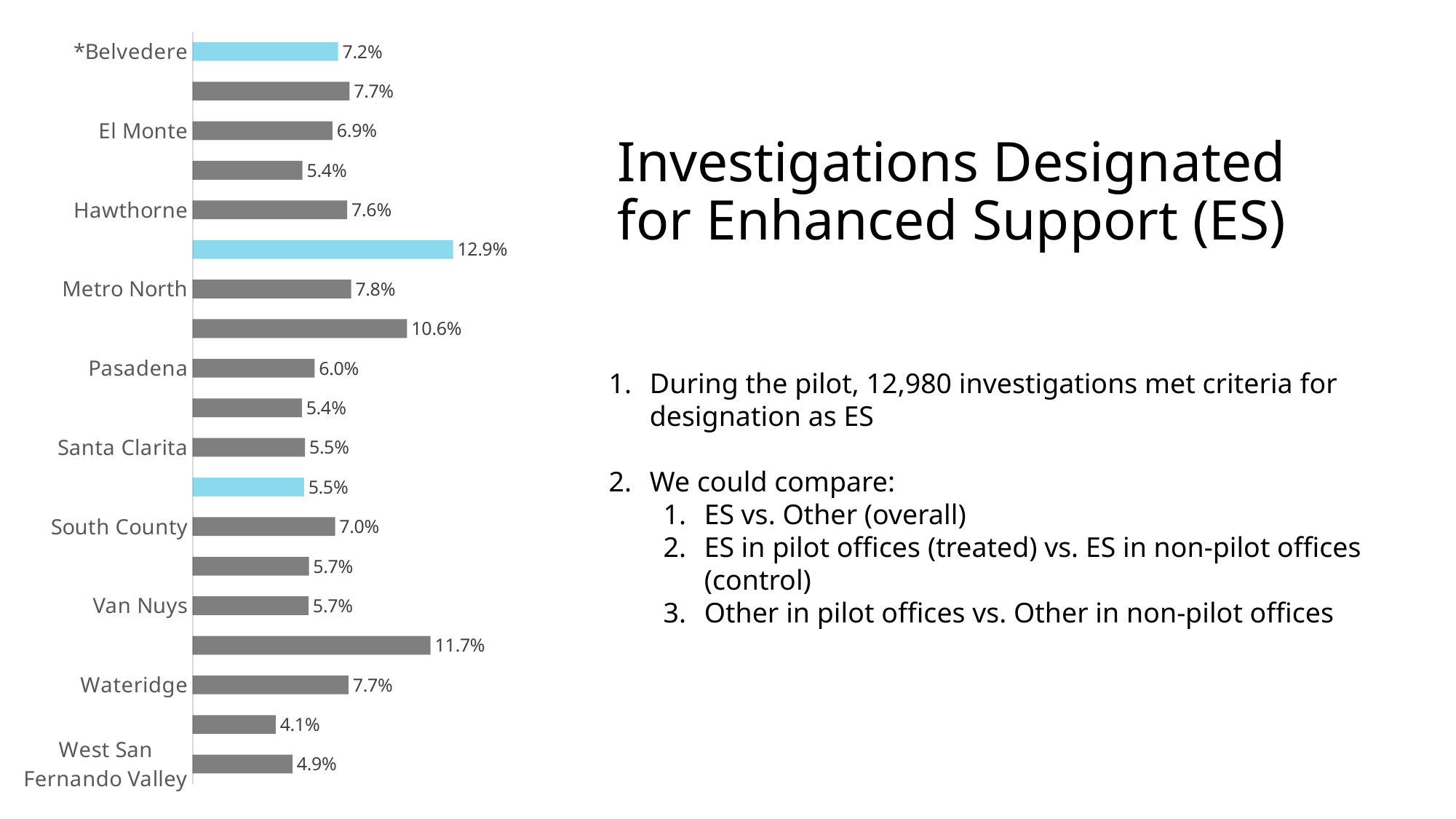
What is the value for Metro North? 7.8% What is the difference between the values for Hawthorne and Santa Clarita? 2.1% What kind of chart is shown on the slide? Bar chart How many bars are plotted on the chart? 19 What is the value for West San Fernando Valley? 4.9% What is the value for Pasadena? 6.0% Which is larger, the value for El Monte or the value for Van Nuys? El Monte What is the highest value shown on the chart? 12.9% What is the title of the slide? Investigations Designated for Enhanced Support (ES) What is the lowest value shown on the chart? 4.1% Which of the labeled offices has the highest value? Metro North What is the value for Belvedere? 7.2%